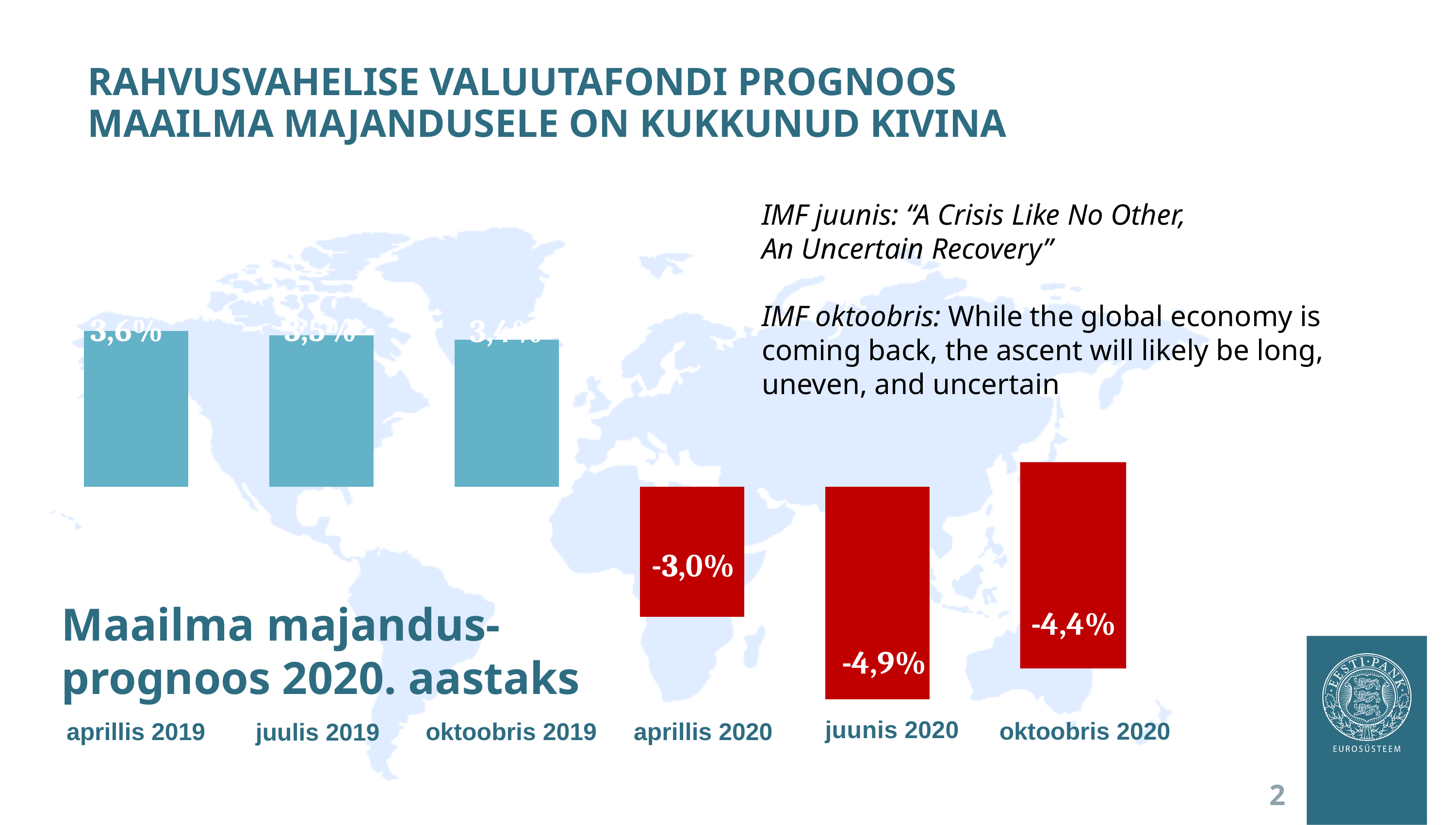
What is the difference between the juunis 2020 and oktoobris 2020 forecasts? 0,5 percentage points Which is larger, the forecast for aprillis 2020 or for juunis 2020? aprillis 2020 What is the difference between the aprillis 2019 and oktoobris 2019 forecasts? 0,2 percentage points What is the forecast value shown for oktoobris 2020? -4,4% What kind of chart is shown on the slide? bar chart What colour are the bars for the 2020 forecasts? red What is the forecast value shown for juunis 2020? -4,9% What is the forecast value shown for aprillis 2019? 3,6% Which forecast date has the lowest value? juunis 2020 What is the forecast value shown for aprillis 2020? -3,0% Which forecast date has the highest value? aprillis 2019 How many forecast dates are shown in the chart? 6